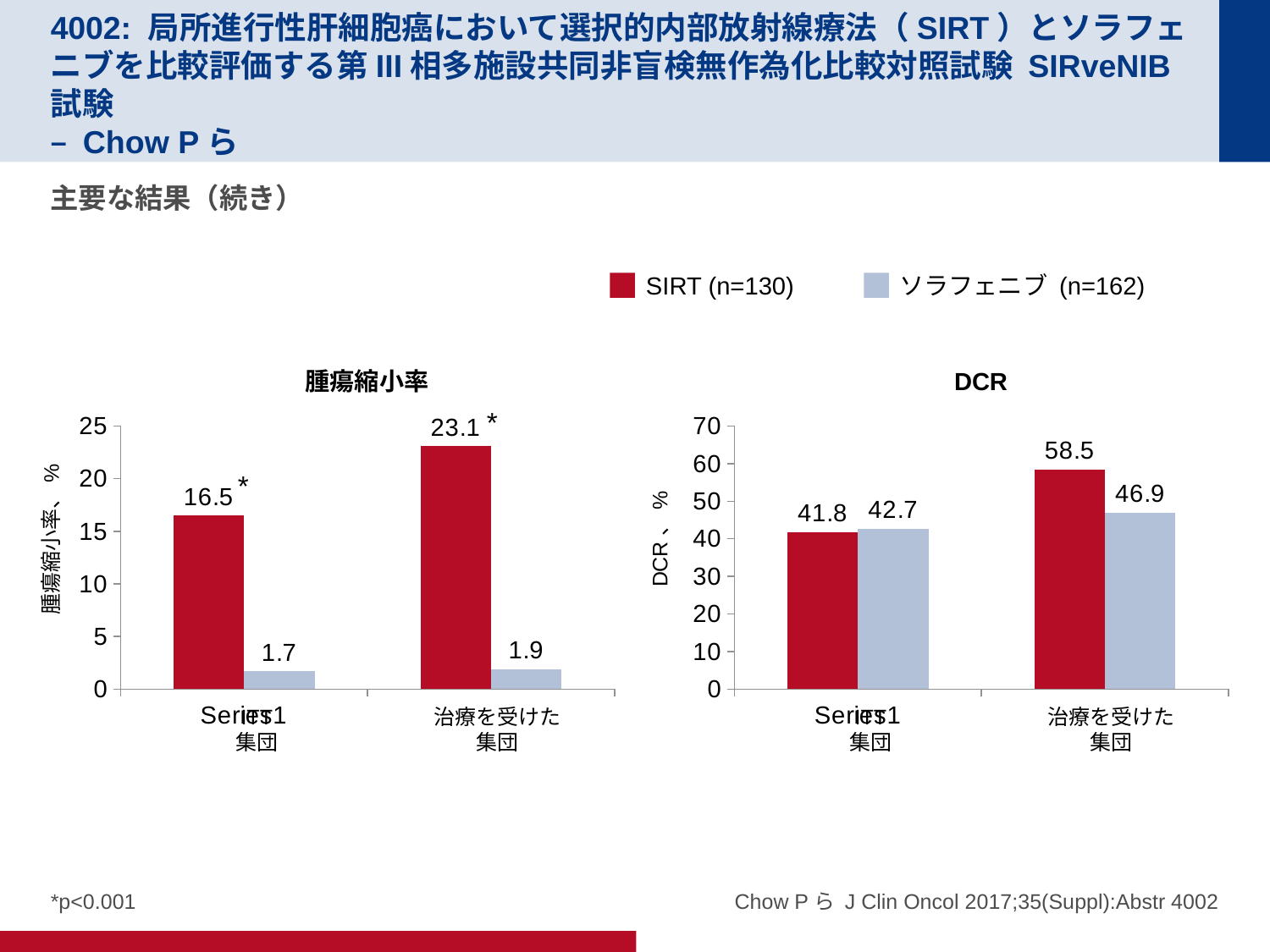
How many series does the legend list? 2 In the DCR chart, is the SIRT value for the 治療を受けた集団 group greater or less than 50? greater In the 腫瘍縮小率 chart, what is the value for SIRT in the 治療を受けた集団 group? 23.1 In the 腫瘍縮小率 chart, what is the lowest value shown? 1.7 In the DCR chart, what is the value for SIRT in the 治療を受けた集団 group? 58.5 In the 腫瘍縮小率 chart, what is the value for ソラフェニブ in the 治療を受けた集団 group? 1.9 In the DCR chart, what is the difference between the SIRT and ソラフェニブ values in the 治療を受けた集団 group? 11.6 What kind of chart is the DCR chart? bar chart In the DCR chart, which series has the larger value in the 治療を受けた集団 group, SIRT or ソラフェニブ? SIRT In the 腫瘍縮小率 chart, what is the difference between the SIRT and ソラフェニブ values in the 治療を受けた集団 group? 21.2 In the DCR chart, what is the value for ソラフェニブ in the 治療を受けた集団 group? 46.9 In the 腫瘍縮小率 chart, what is the highest value shown? 23.1